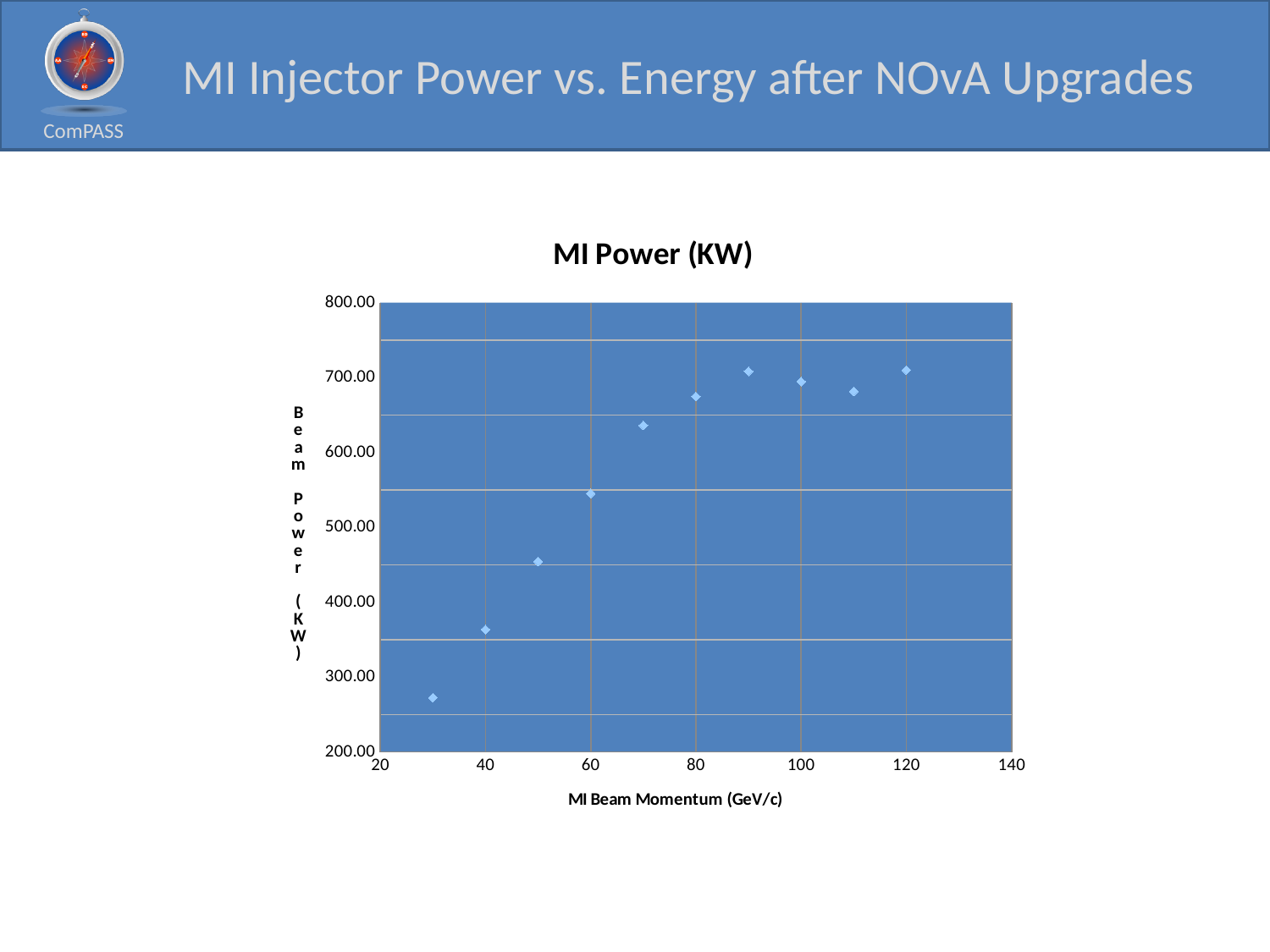
What is the title of the chart? MI Power (KW) Which has the higher beam power, 40 GeV/c or 60 GeV/c? 60 GeV/c Is the beam power at 30 GeV/c greater or less than 300.00? less Is the beam power at 80 GeV/c greater or less than 700.00? less How many data points are plotted on the chart? 10 Is the beam power at 50 GeV/c greater or less than 500.00? less Do the beam power values rise or fall as momentum increases from 30 to 70 GeV/c? rise What is the label of the x axis? MI Beam Momentum (GeV/c) What kind of chart is shown on the slide? scatter chart At which MI beam momentum is the beam power lowest? 30